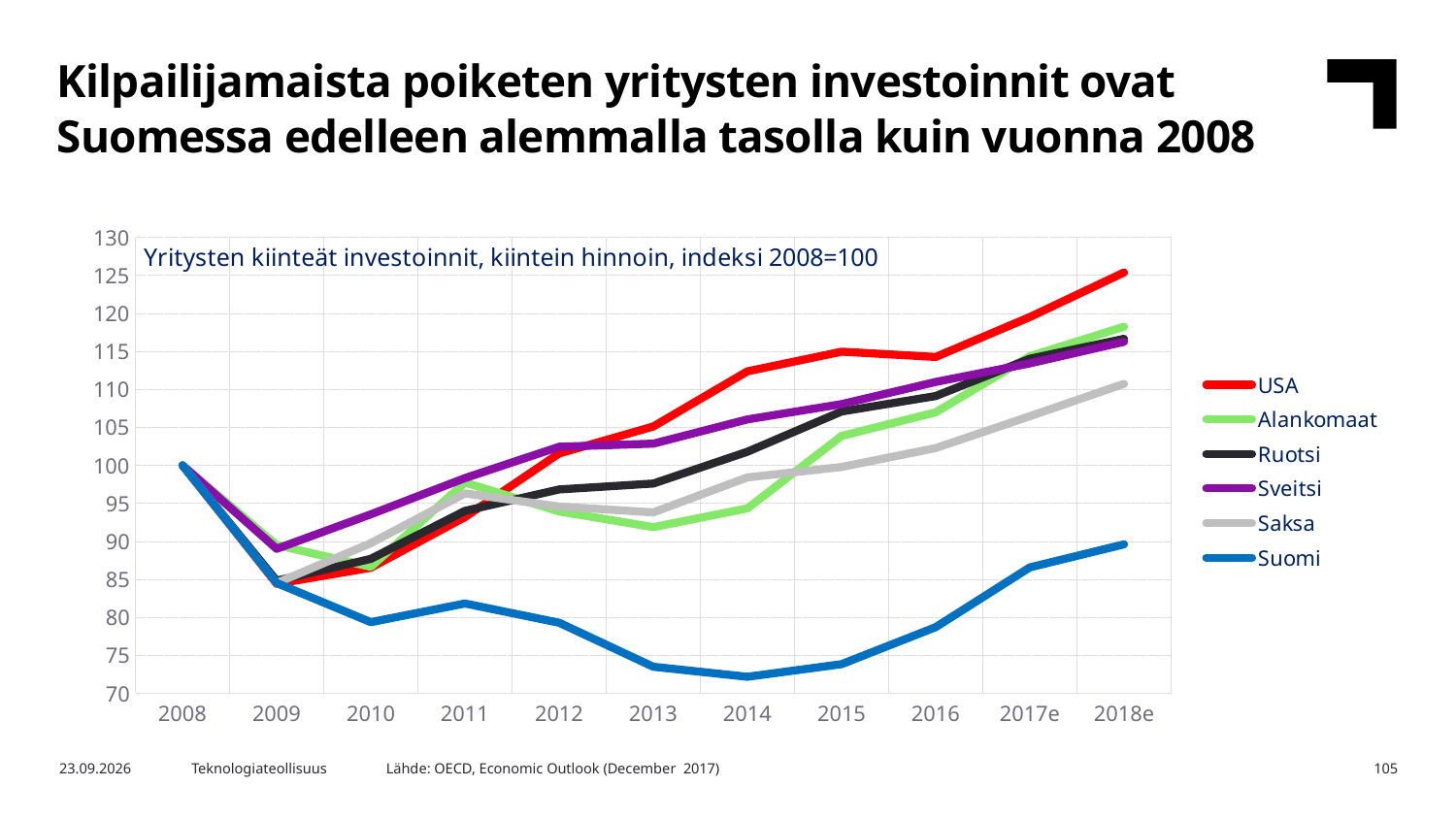
How many years are shown on the x axis? 11 What is the title of the chart? Yritysten kiinteät investoinnit, kiintein hinnoin, indeksi 2008=100 What kind of chart is shown on the slide? line chart Is the value for USA in 2018e greater or less than 120? greater Does the value for Suomi rise or fall from 2008 to 2014? fall How many series does the legend list? 6 Which is larger in 2018e, the value for Sveitsi or the value for Saksa? Sveitsi Which country has the lowest value in 2018e? Suomi Is the value for Suomi in 2014 greater or less than 75? less What is the index value for Suomi in 2008? 100 Which country has the highest value in 2014? USA Which country has the highest value in 2018e? USA